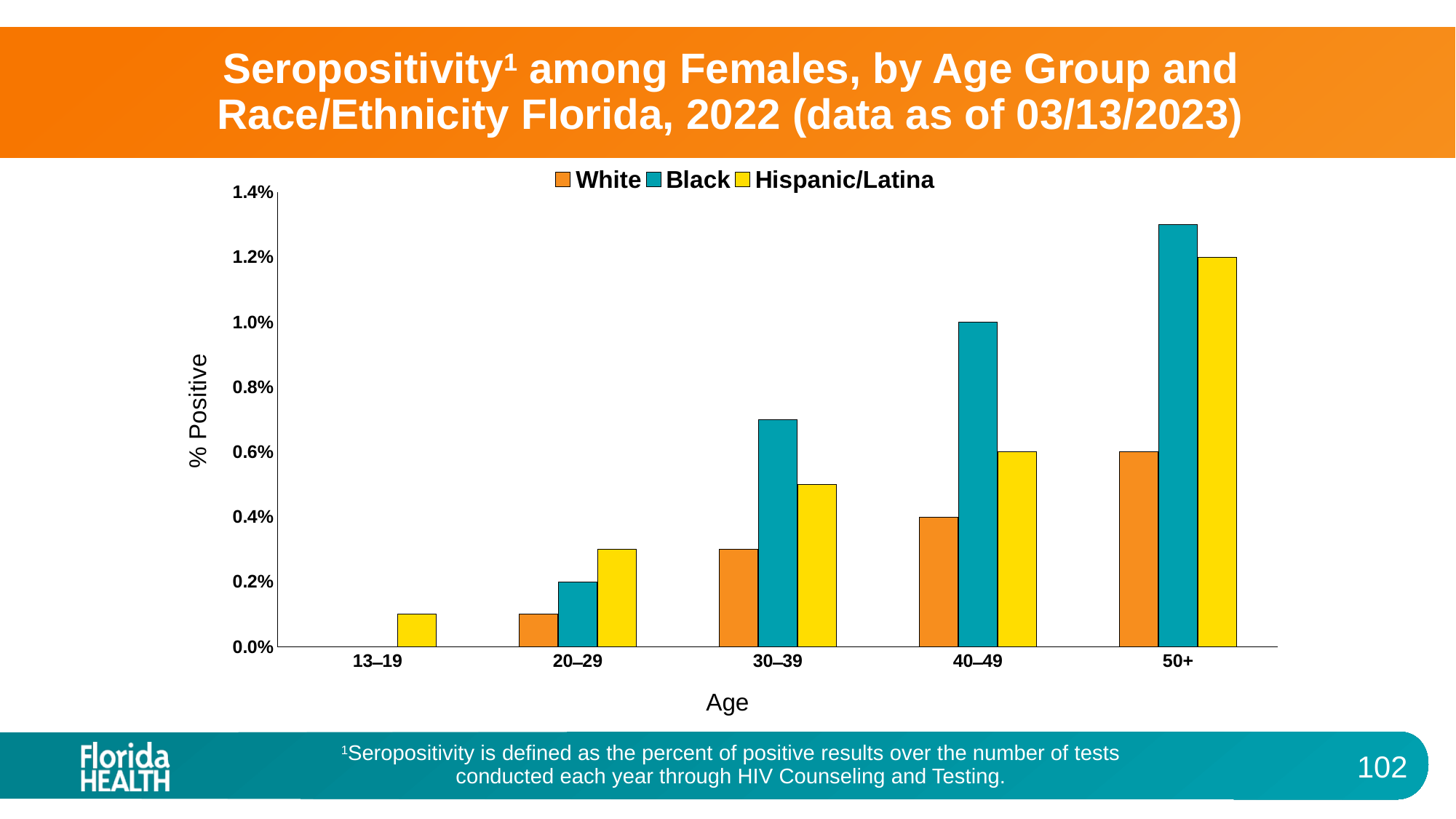
Which age group has the lowest seropositivity values overall? 13–19 How many series does the legend list? 3 What kind of chart is shown on the slide? bar chart Do seropositivity values generally rise or fall as age group increases? rise What is the seropositivity value for Hispanic/Latina females aged 50+? 1.2% What is the seropositivity value for White females aged 40–49? 0.4% How many age groups are shown on the x axis? 5 What is the difference between the values for Black and Hispanic/Latina females aged 40–49? 0.4% What is the seropositivity value for Black females aged 40–49? 1.0% What is the seropositivity value for White females aged 50+? 0.6% Which race/ethnicity and age group combination has the highest seropositivity? Black, 50+ Is the value for Black females aged 50+ greater or less than 1.2%? greater